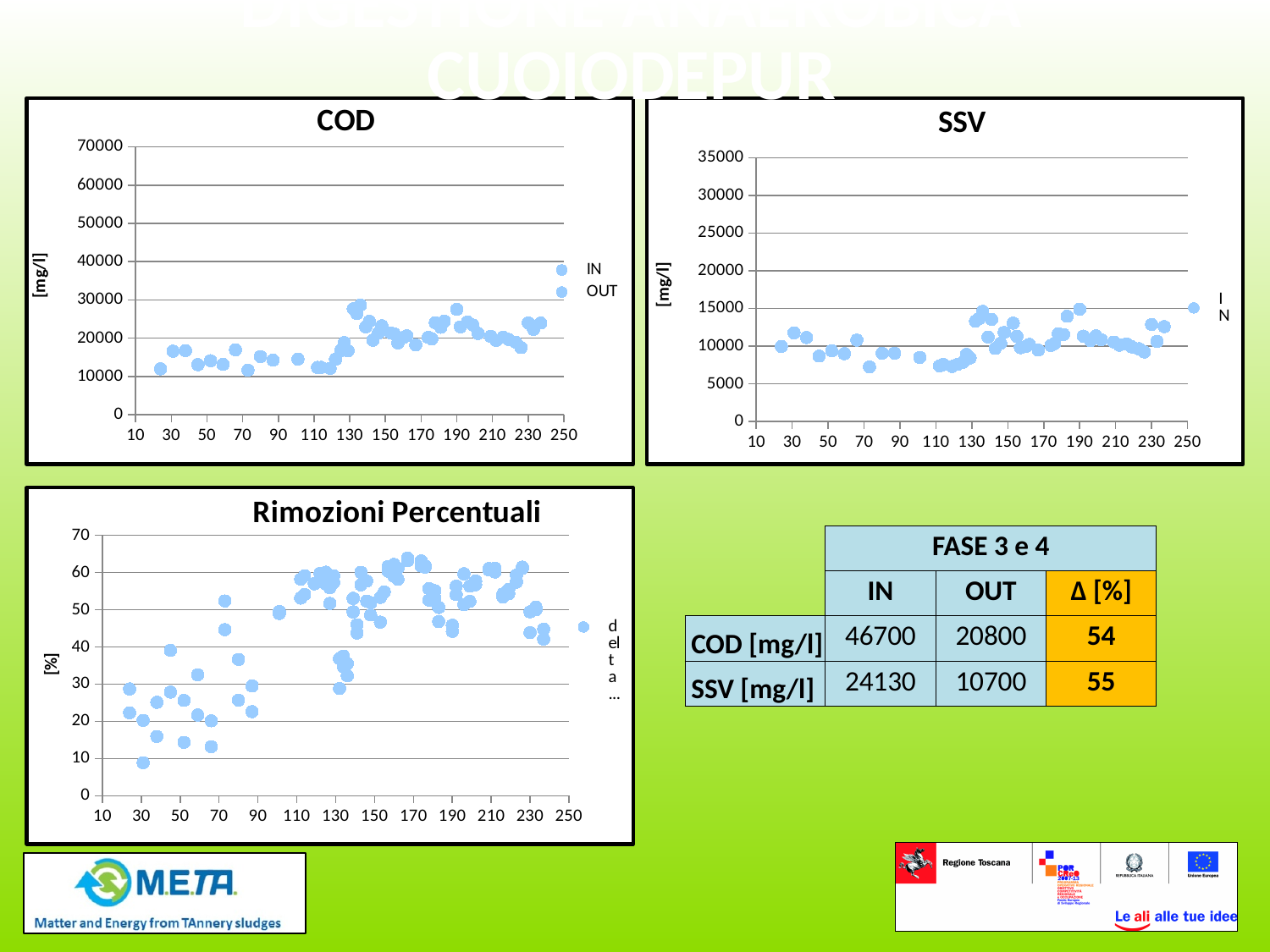
In the SSV chart, is the lowest plotted point greater or less than 5000? greater What kind of chart is the COD chart? scatter chart In the Rimozioni Percentuali chart, is the lowest plotted point greater or less than 20? less In the SSV chart, is the highest plotted point greater or less than 20000? less In the Rimozioni Percentuali chart, do the plotted values generally rise or fall as the x-axis increases? rise How many series does the legend of the COD chart list? 2 What kind of chart is the Rimozioni Percentuali chart? scatter chart What are the two series named in the legend of the COD chart? IN and OUT What is the y-axis label of the SSV chart? [mg/l]